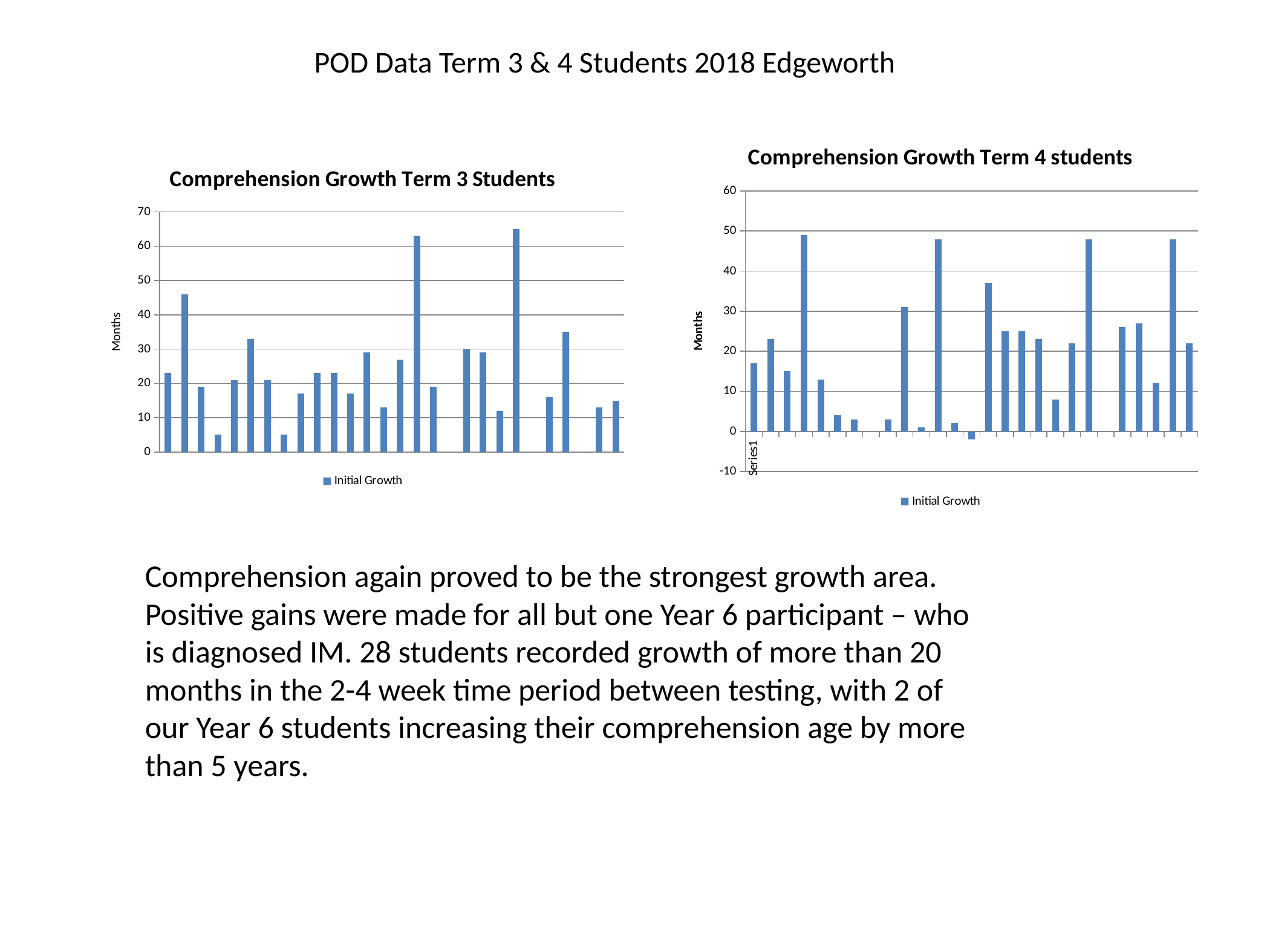
What kind of chart is the "Comprehension Growth Term 4 students" chart? bar chart How many series does the legend of the "Comprehension Growth Term 3 Students" chart list? 1 In the "Comprehension Growth Term 3 Students" chart, is the value of the shortest bar greater or less than 10? less How many series does the legend of the "Comprehension Growth Term 4 students" chart list? 1 Which chart has the taller highest bar, "Comprehension Growth Term 3 Students" or "Comprehension Growth Term 4 students"? Comprehension Growth Term 3 Students In the "Comprehension Growth Term 4 students" chart, is the lowest bar value greater or less than 0? less What is the legend entry shown on the "Comprehension Growth Term 3 Students" chart? Initial Growth In the "Comprehension Growth Term 3 Students" chart, is the value of the tallest bar greater or less than 60? greater What is the label on the vertical axis of the "Comprehension Growth Term 4 students" chart? Months What kind of chart is the "Comprehension Growth Term 3 Students" chart? bar chart